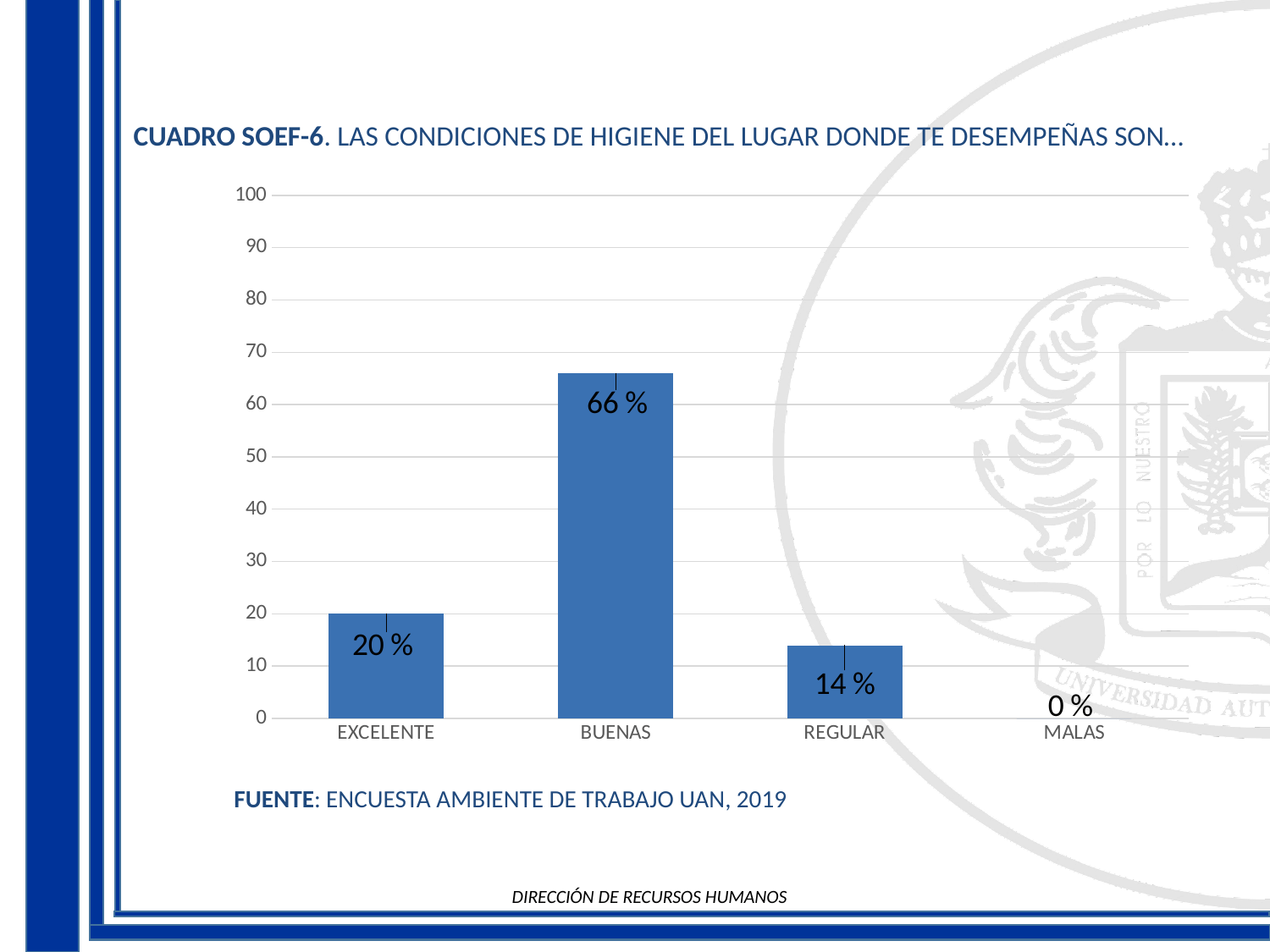
What is the difference between the values for BUENAS and EXCELENTE? 46 % Which category has the lowest value? MALAS Is the value for BUENAS greater or less than 50? greater What source is cited below the chart? ENCUESTA AMBIENTE DE TRABAJO UAN, 2019 How many categories are shown on the x axis? 4 What is the value for BUENAS? 66 % What is the value for REGULAR? 14 % What is the value for EXCELENTE? 20 % Which category has the highest value? BUENAS What kind of chart is shown on the slide? bar chart Which is larger, the value for EXCELENTE or the value for REGULAR? EXCELENTE What is the value for MALAS? 0 %